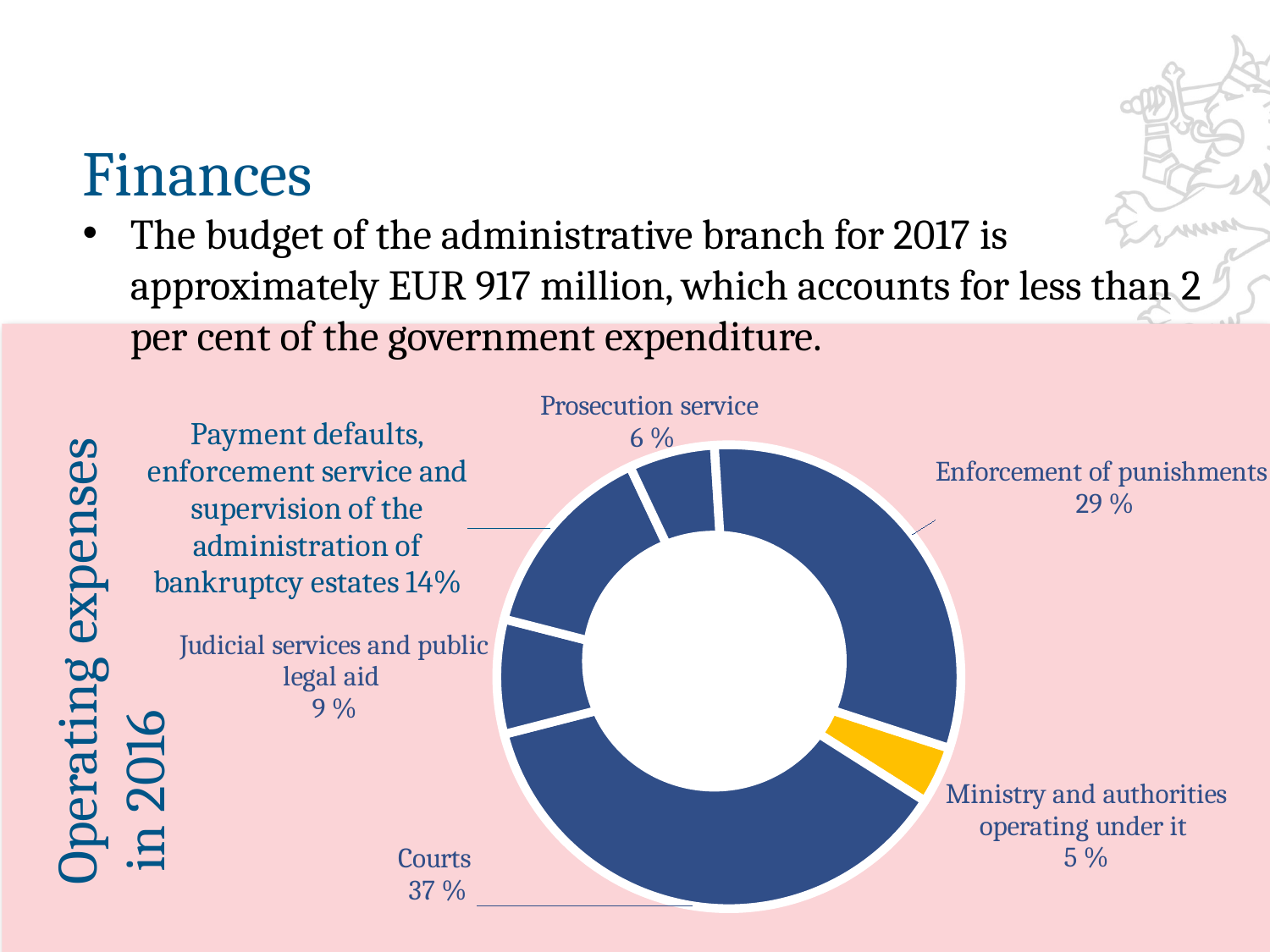
What share of operating expenses in 2016 goes to Judicial services and public legal aid? 9 % Which has a larger share of operating expenses: Judicial services and public legal aid, or Payment defaults, enforcement service and supervision of the administration of bankruptcy estates? Payment defaults, enforcement service and supervision of the administration of bankruptcy estates What share of operating expenses in 2016 goes to Courts? 37 % What share of operating expenses in 2016 goes to the Ministry and authorities operating under it? 5 % How many percentage points larger is the Courts share than the Enforcement of punishments share? 8 Which category has the largest share of operating expenses in 2016? Courts What share of operating expenses in 2016 goes to Enforcement of punishments? 29 % What kind of chart is used to show operating expenses in 2016? Doughnut (pie) chart How many categories are shown in the operating expenses chart? 6 What share of operating expenses in 2016 goes to the Prosecution service? 6 % Which category has the smallest share of operating expenses in 2016? Ministry and authorities operating under it Which slice of the operating expenses chart is coloured yellow? Ministry and authorities operating under it